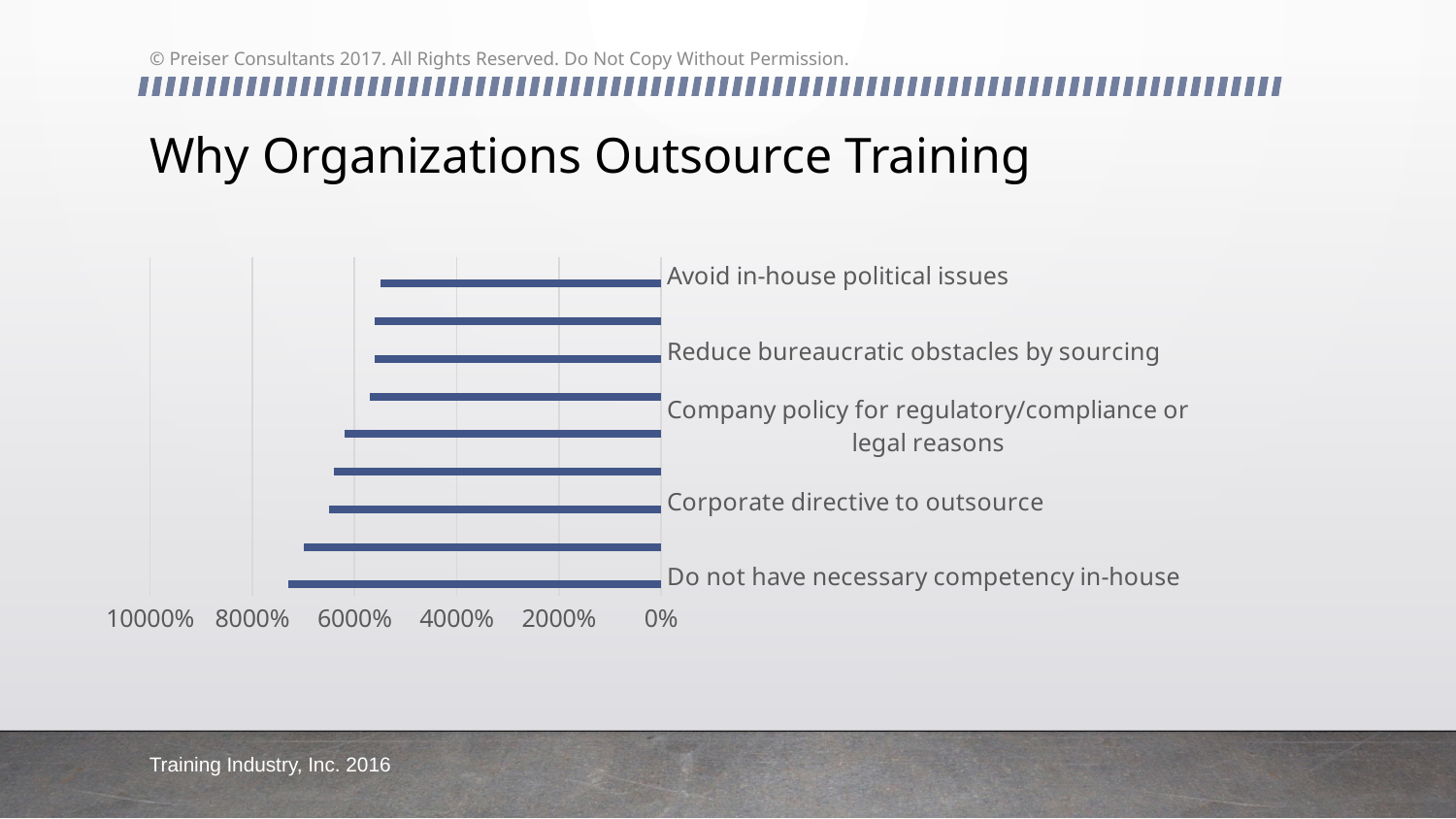
Is the value for 'Corporate directive to outsource' greater or less than 4000%? greater What is the title of the chart on the slide? Why Organizations Outsource Training How many bars are plotted in the chart? 9 Is the value for 'Avoid in-house political issues' greater or less than 6000%? less Which labeled category has the longest bar in the chart? Do not have necessary competency in-house What kind of chart is shown on the slide? Bar chart Which is larger: the value for 'Corporate directive to outsource' or the value for 'Reduce bureaucratic obstacles by sourcing'? Corporate directive to outsource Do the bar lengths generally increase or decrease going from the top bar to the bottom bar? increase What is the highest value shown on the horizontal axis of the chart? 10000% Is the value for 'Do not have necessary competency in-house' greater or less than 6000%? greater Which is larger: the value for 'Do not have necessary competency in-house' or the value for 'Avoid in-house political issues'? Do not have necessary competency in-house